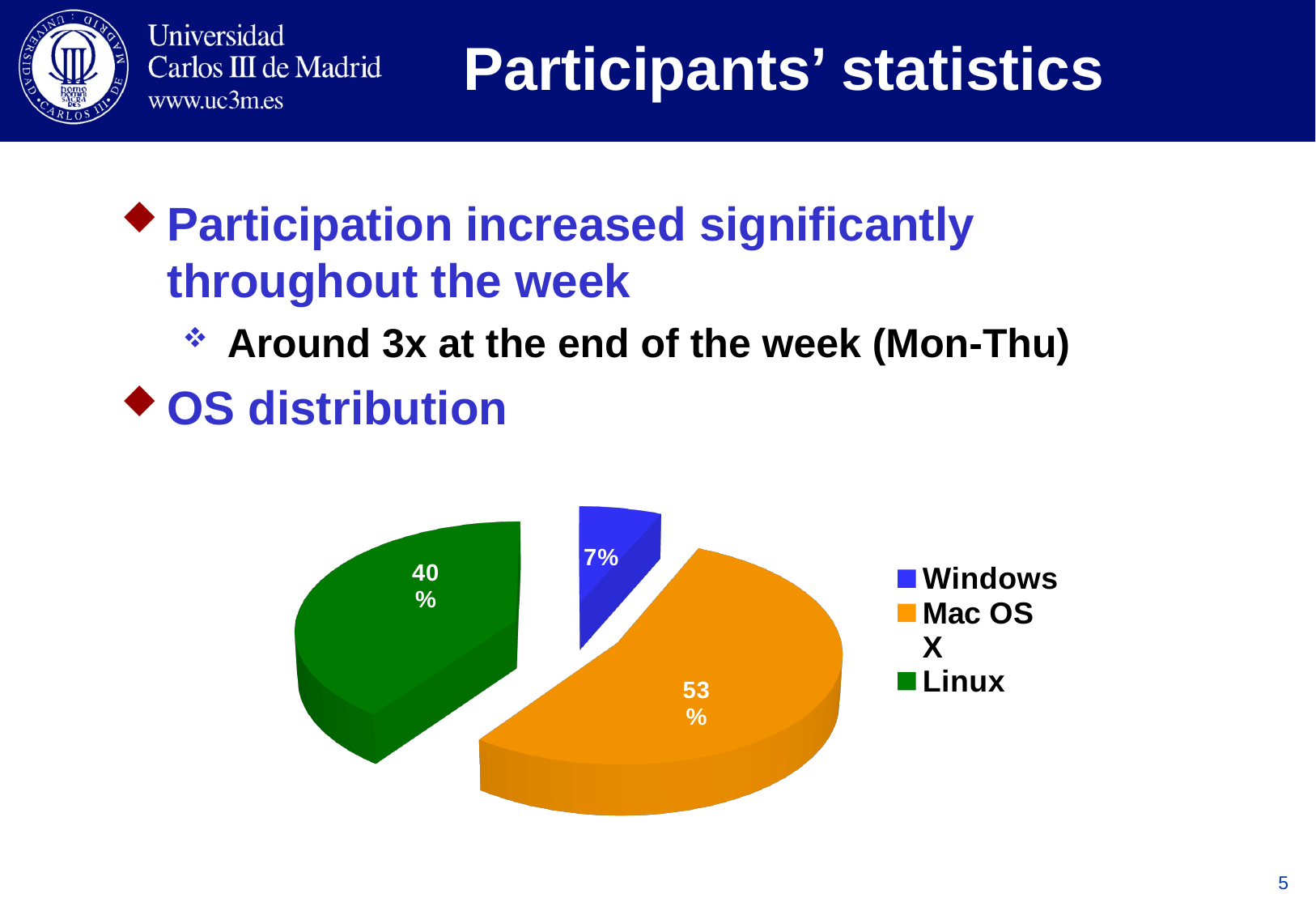
What share of the pie does Linux have? 40% What is the difference in percentage points between the Mac OS X share and the Linux share? 13 What kind of chart is shown on the slide? Pie chart What is the difference in percentage points between the Linux share and the Windows share? 33 Which operating system has the largest share of the pie? Mac OS X Which has a larger share, Linux or Windows? Linux What share of the pie does Windows have? 7% How many slices does the pie chart have? 3 Which operating system has the smallest share of the pie? Windows Which has a larger share, Mac OS X or Linux? Mac OS X What colour is the Linux slice in the pie chart? Green What share of the pie does Mac OS X have? 53%